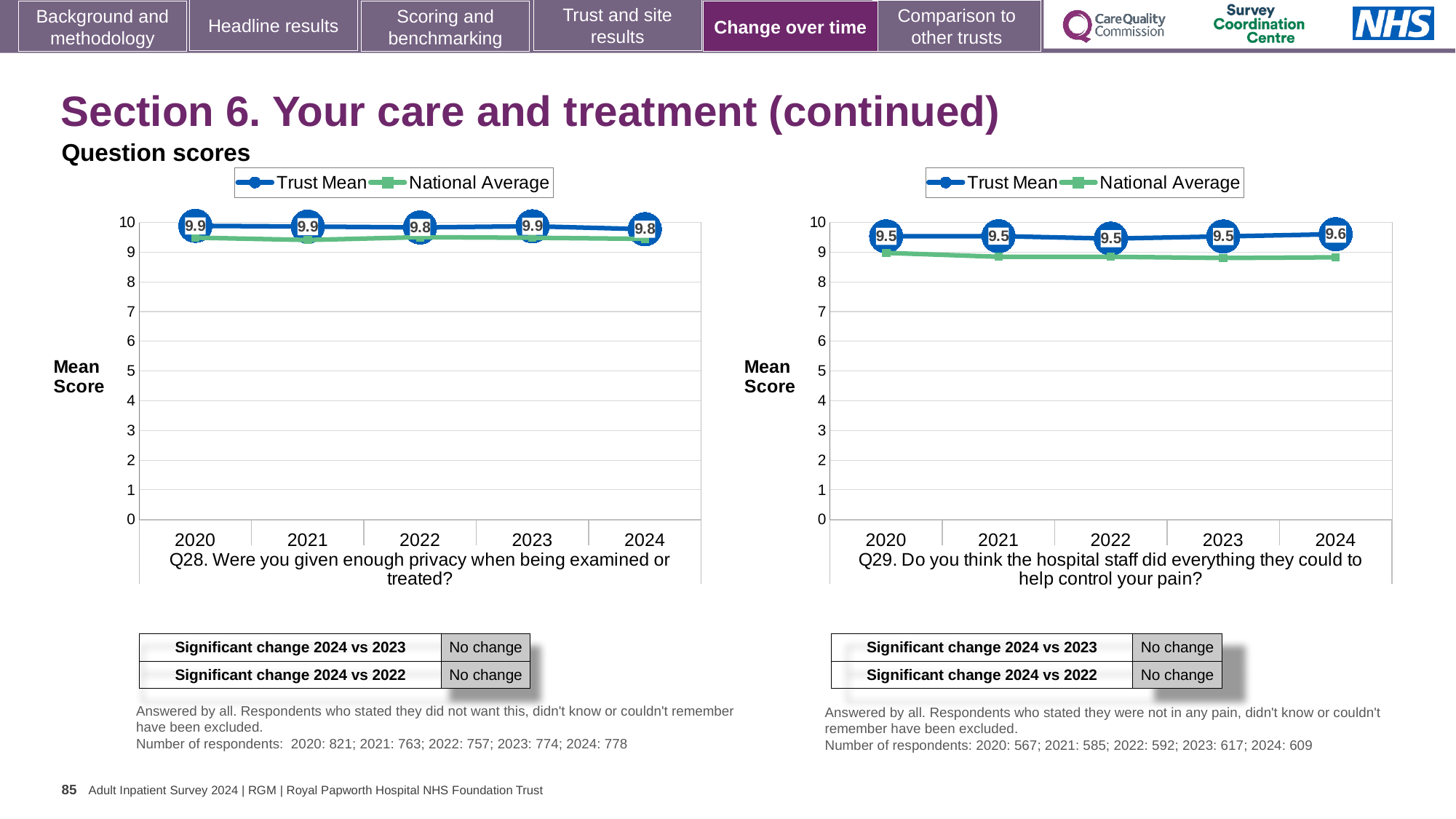
In the Q29 chart (right), what is the Trust Mean score for 2024? 9.6 How many series does the legend of the Q29 chart (right) list? 2 In the Q28 chart (left), what is the Trust Mean score for 2020? 9.9 In the Q29 chart (right), what is the Trust Mean score for 2022? 9.5 In the Q29 chart (right), which series has the higher value in 2023, Trust Mean or National Average? Trust Mean In the Q28 chart (left), what is the difference between the Trust Mean scores for 2020 and 2022? 0.1 In the Q28 chart (left), what is the Trust Mean score for 2024? 9.8 How many years are plotted on the x axis of the Q28 chart (left)? 5 What kind of chart is the Q28 chart (left)? Line chart In the Q28 chart (left), is the National Average for 2020 greater or less than 9? greater In the Q29 chart (right), is the National Average for 2024 greater or less than 9? less In the Q29 chart (right), what is the difference between the Trust Mean scores for 2024 and 2023? 0.1